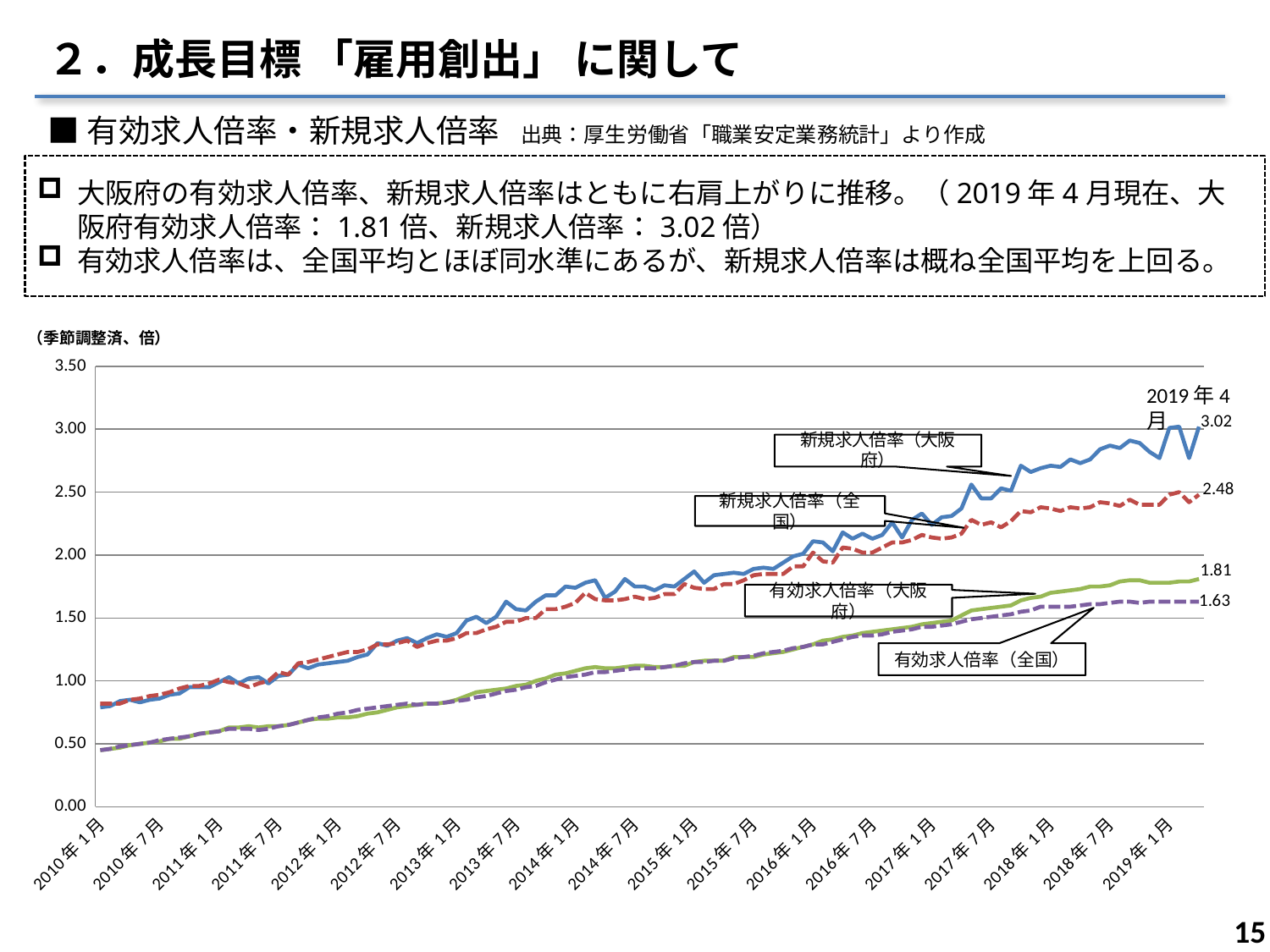
At 2019年4月, what is the difference between 新規求人倍率（大阪府） and 新規求人倍率（全国）? 0.54 What is the value of 新規求人倍率（全国） at 2019年4月? 2.48 Which series has the highest value at 2019年4月? 新規求人倍率（大阪府） What kind of chart is shown on the slide? line chart Do the values of 新規求人倍率（大阪府） generally rise or fall from 2010年1月 to 2019年4月? rise Which series has the lowest value at 2019年4月? 有効求人倍率（全国） Is the value of 新規求人倍率（大阪府） at 2010年1月 greater or less than 1.00? less How many data series are plotted on the chart? 4 What is the value of 有効求人倍率（大阪府） at 2019年4月? 1.81 What is the value of 有効求人倍率（全国） at 2019年4月? 1.63 At 2019年4月, what is the difference between 有効求人倍率（大阪府） and 有効求人倍率（全国）? 0.18 What is the value of 新規求人倍率（大阪府） at 2019年4月? 3.02